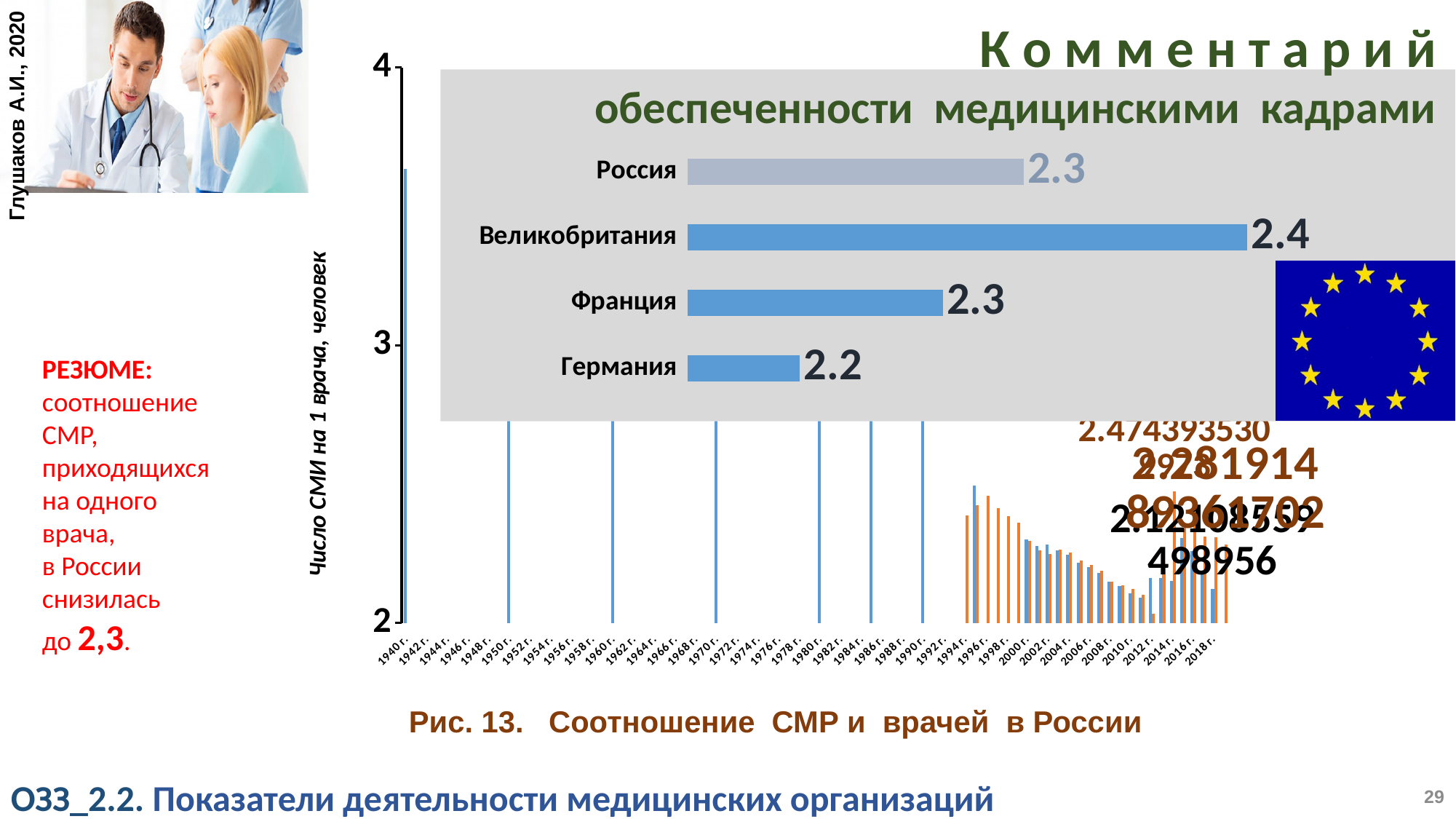
In the inset horizontal bar chart (обеспеченности медицинскими кадрами), what is the value for Германия? 2.2 In the inset horizontal bar chart (обеспеченности медицинскими кадрами), what is the difference between the values for Великобритания and Германия? 0.2 In the large chart Рис. 13 (Соотношение СМР и врачей в России), is the value for 1940 г. greater or less than 3? greater In the inset horizontal bar chart (обеспеченности медицинскими кадрами), which country has the lowest value? Германия What kind of chart is the inset chart titled обеспеченности медицинскими кадрами? Bar chart What is the y-axis label of the large chart Рис. 13 (Соотношение СМР и врачей в России)? Число СМИ на 1 врача, человек How many countries are shown in the inset horizontal bar chart (обеспеченности медицинскими кадрами)? 4 In the inset horizontal bar chart (обеспеченности медицинскими кадрами), which country has the highest value? Великобритания In the inset horizontal bar chart (обеспеченности медицинскими кадрами), which is larger: the value for Великобритания or the value for Германия? Великобритания In the inset horizontal bar chart (обеспеченности медицинскими кадрами), what is the value for Франция? 2.3 In the inset horizontal bar chart (обеспеченности медицинскими кадрами), what is the value for Россия? 2.3 In the inset horizontal bar chart (обеспеченности медицинскими кадрами), what is the value for Великобритания? 2.4